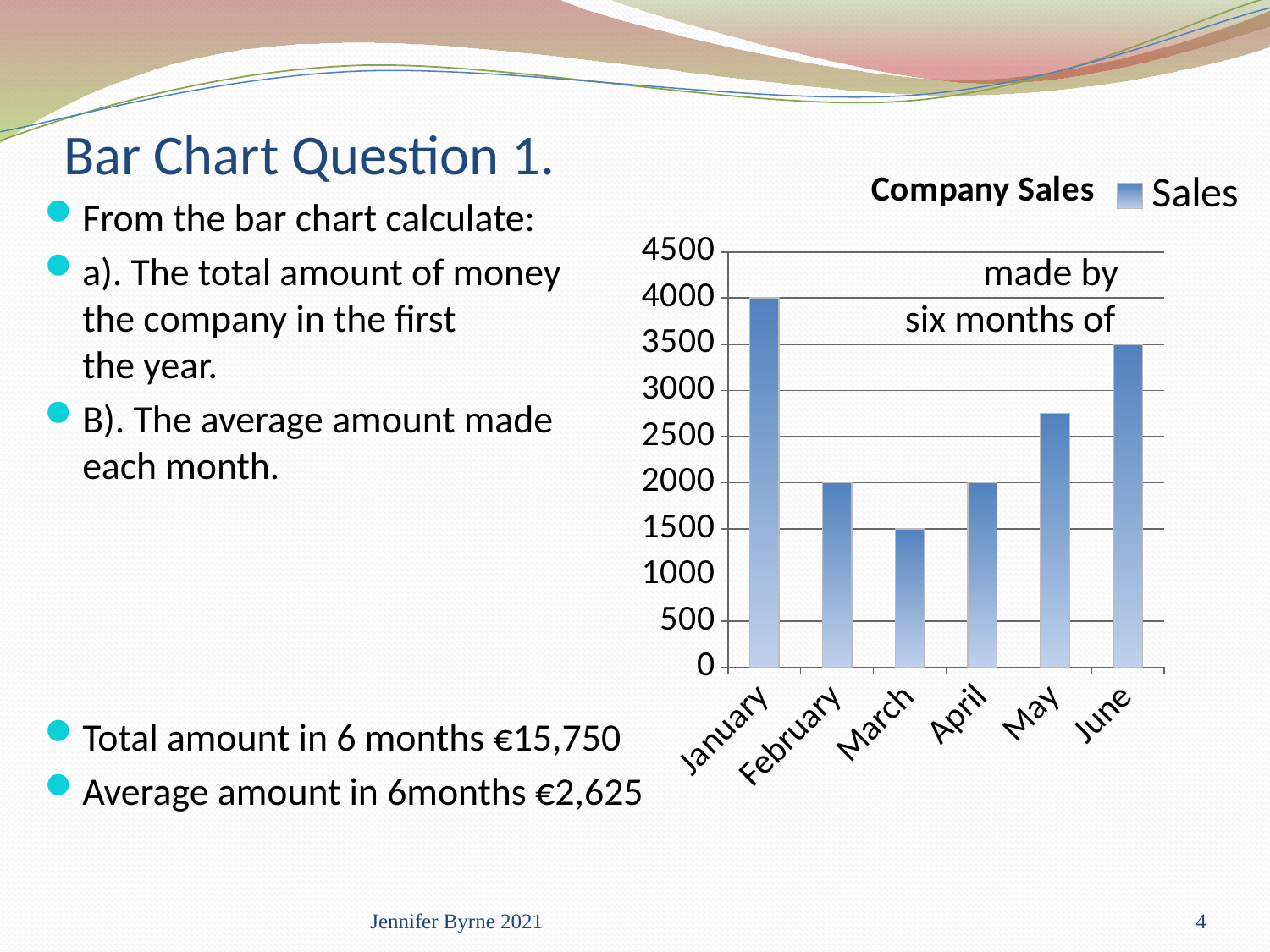
What kind of chart is shown on the slide? bar chart Which month has the lowest sales in the Company Sales chart? March What is the sales value for January in the Company Sales chart? 4000 Which month has higher sales, June or May? June How many months are plotted in the Company Sales chart? 6 What is the name of the series shown in the legend of the Company Sales chart? Sales What is the difference between the sales for January and March? 2500 Which month has the highest sales in the Company Sales chart? January What is the sales value for March in the Company Sales chart? 1500 What is the sales value for June in the Company Sales chart? 3500 How many series does the legend of the Company Sales chart list? 1 Is the sales value for May greater or less than 2500? greater